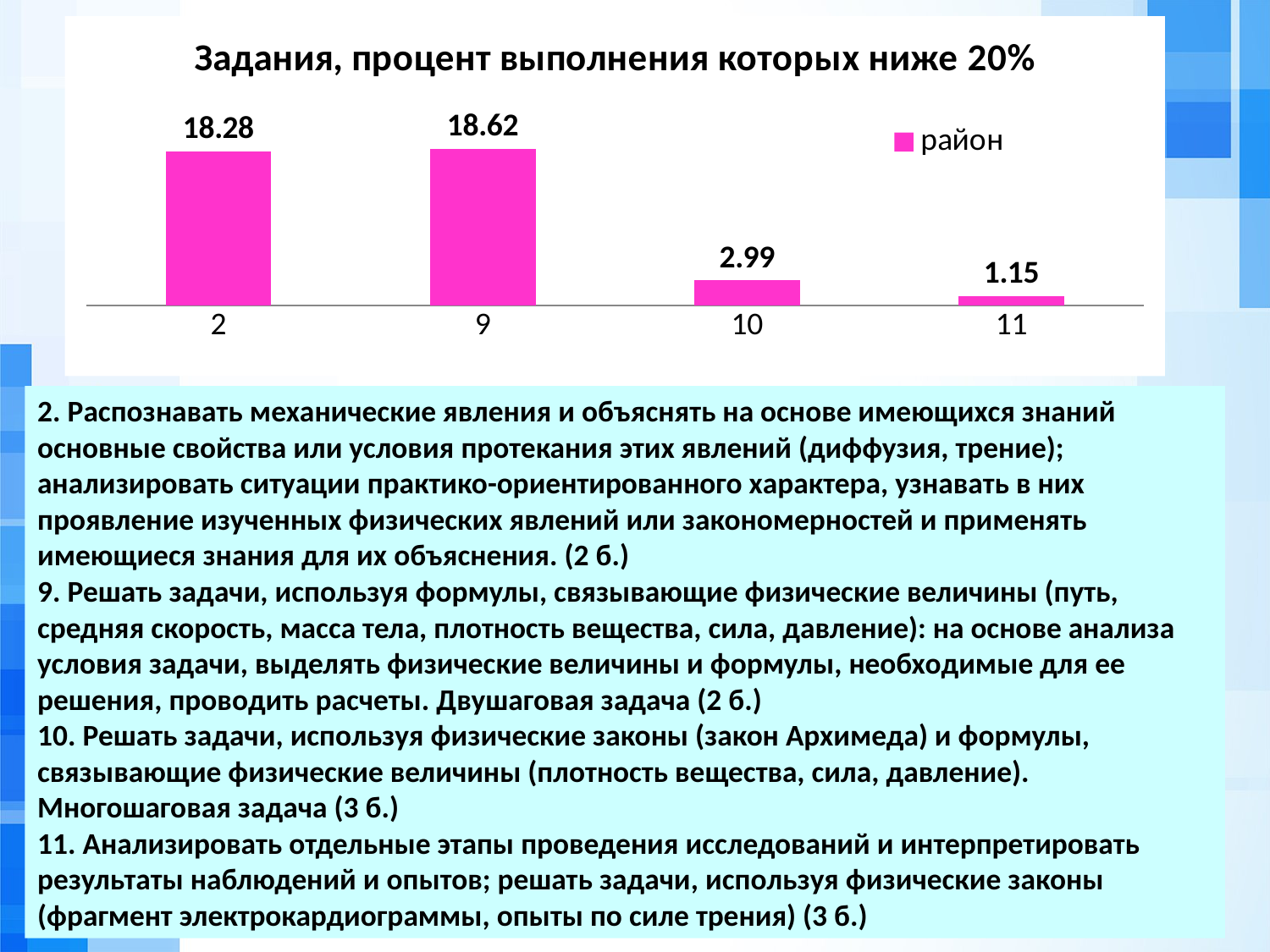
What is the difference between the values for categories 9 and 2? 0.34 What is the difference between the values for categories 10 and 11? 1.84 Which category has the lowest value? 11 What is the value for category 10? 2.99 Which is larger, the value for category 10 or the value for category 11? 10 What type of chart is shown? bar chart What is the title of the chart? Задания, процент выполнения которых ниже 20% What is the value for category 9? 18.62 What is the value for category 2? 18.28 How many categories are shown on the x axis? 4 What is the value for category 11? 1.15 Which category has the highest value? 9